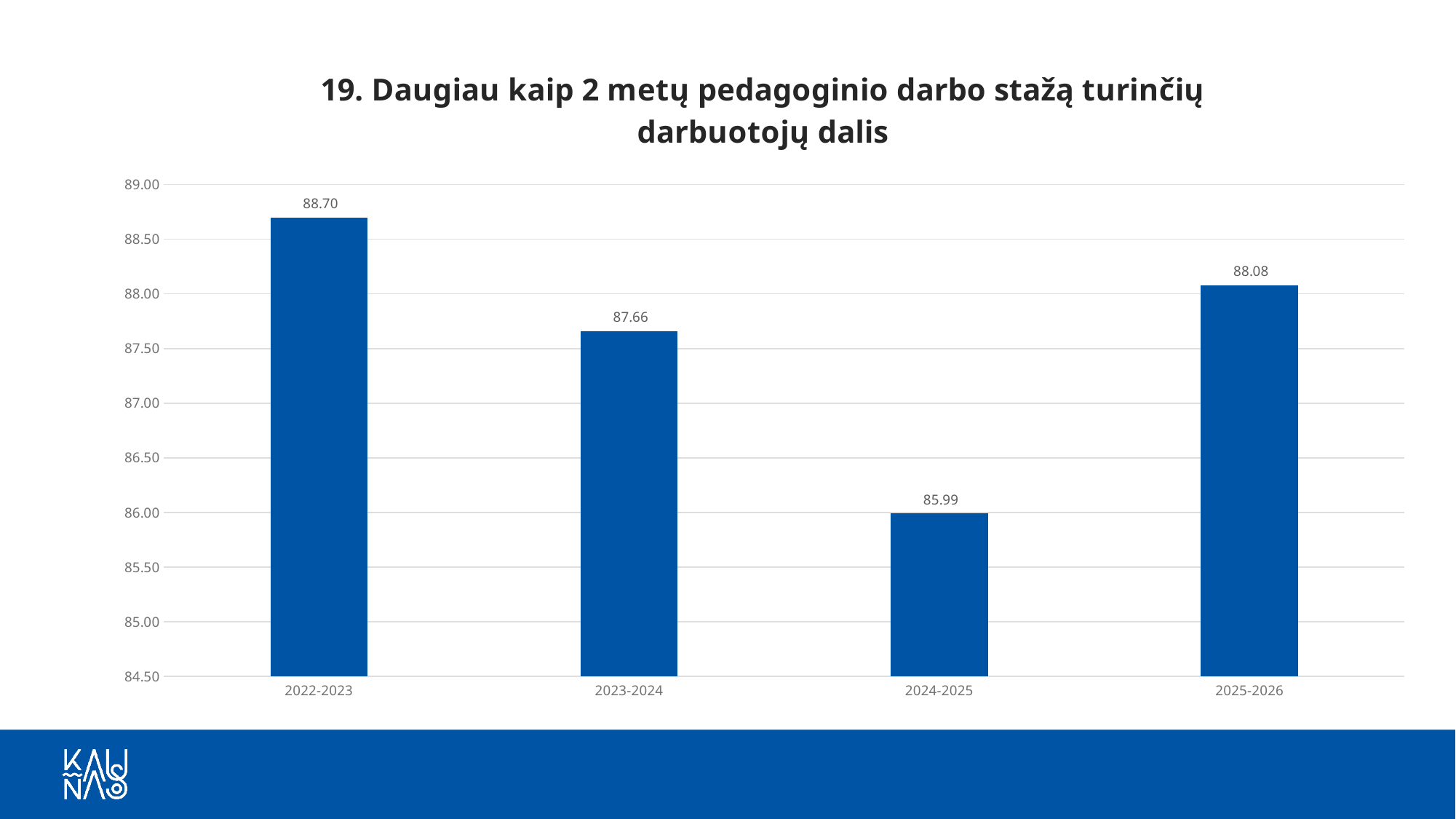
What kind of chart is shown on the slide? bar chart Is the value for 2024-2025 greater or less than 86.50? less What is the value for 2024-2025? 85.99 Which category has the highest value? 2022-2023 What is the difference between the values for 2022-2023 and 2024-2025? 2.71 What is the value for 2023-2024? 87.66 How many categories are shown on the x axis? 4 What is the value for 2025-2026? 88.08 Which category has the lowest value? 2024-2025 What is the difference between the values for 2025-2026 and 2023-2024? 0.42 What is the value for 2022-2023? 88.70 Which is larger, the value for 2023-2024 or the value for 2025-2026? 2025-2026